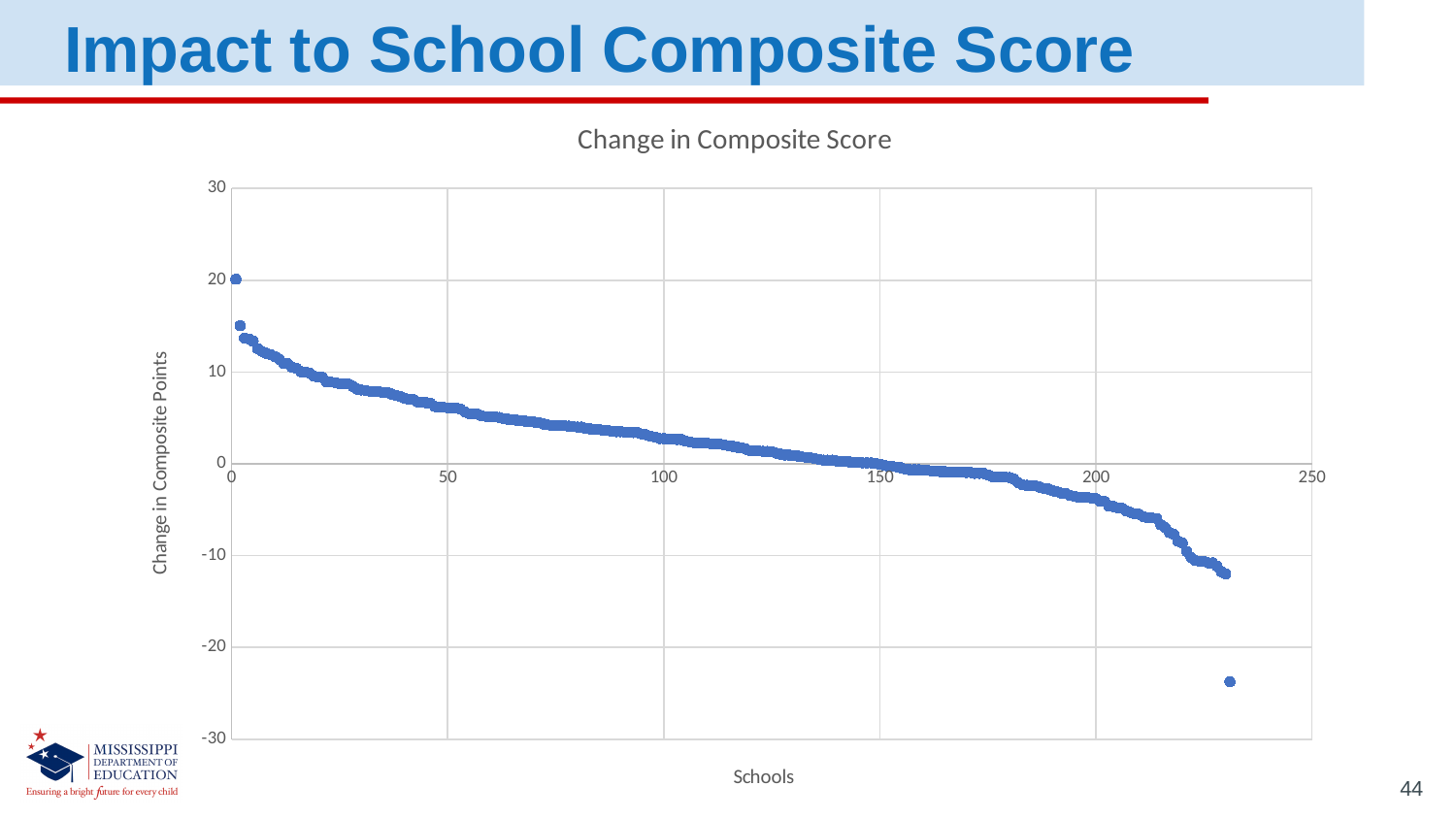
Is the value of the highest plotted point greater or less than 10? greater What is the title of the chart? Change in Composite Score Is the value of the point plotted at about 50 on the x axis greater or less than 0? greater Is the value of the point plotted at about 100 on the x axis greater or less than 10? less Do the plotted values rise or fall as you move from left to right along the x axis? fall Which is larger: the value of the point near 50 on the x axis or the value of the point near 200 on the x axis? the point near 50 What is the highest value shown on the vertical axis? 30 What is the label of the vertical axis of the chart? Change in Composite Points What kind of chart is shown on the slide? scatter chart